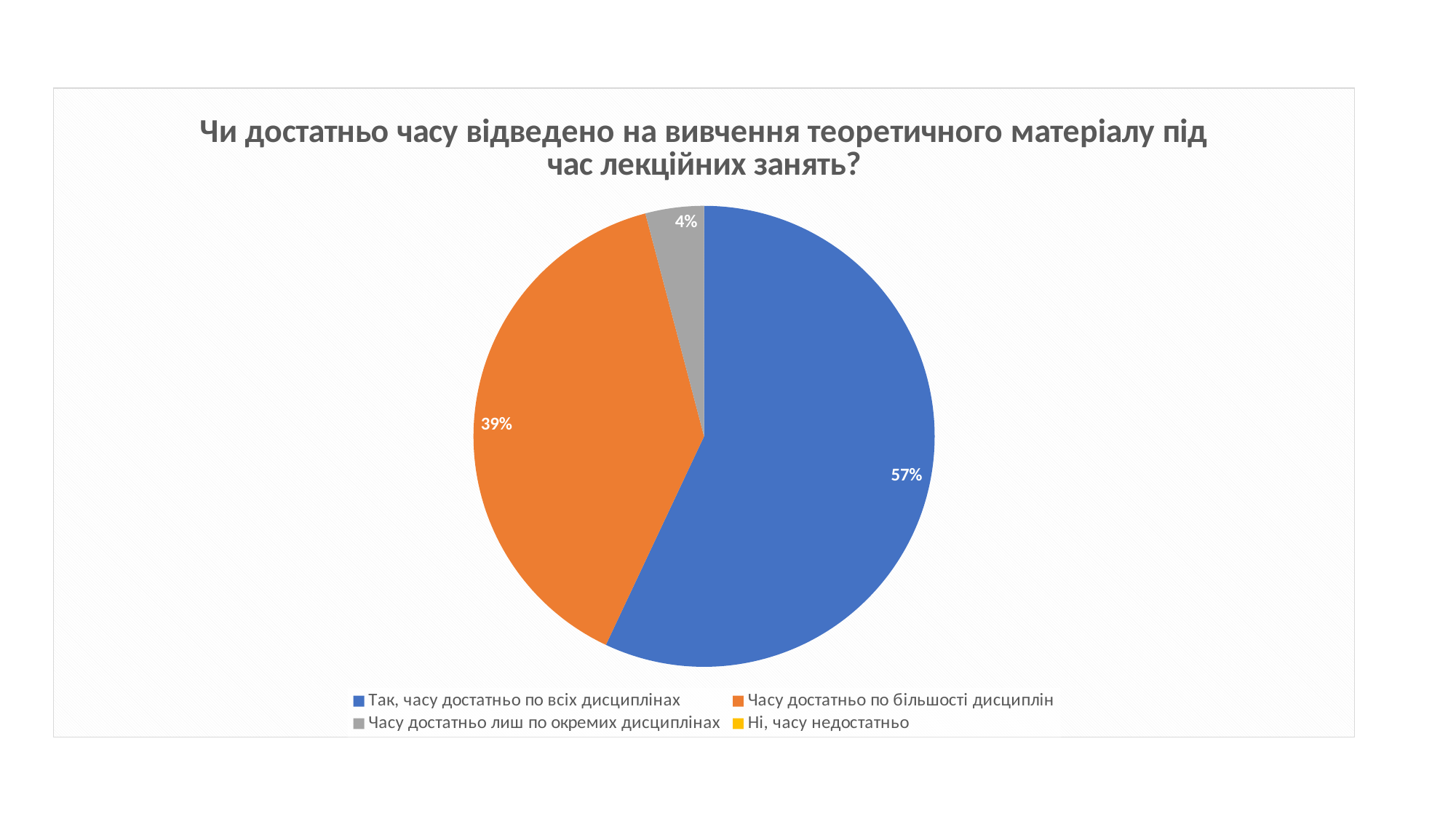
What percentage of respondents answered "Часу достатньо по більшості дисциплін"? 39% What is the title of the chart? Чи достатньо часу відведено на вивчення теоретичного матеріалу під час лекційних занять? What share of the pie does the blue slice represent? 57% What percentage of respondents answered "Часу достатньо лиш по окремих дисциплінах"? 4% What colour represents "Часу достатньо по більшості дисциплін" in the chart? Orange Which of the labelled slices has the smallest share of the pie? Часу достатньо лиш по окремих дисциплінах By how many percentage points does "Так, часу достатньо по всіх дисциплінах" exceed "Часу достатньо по більшості дисциплін"? 18 percentage points Which answer option has the largest share of the pie? Так, часу достатньо по всіх дисциплінах Which is larger: the share for "Часу достатньо по більшості дисциплін" or the share for "Часу достатньо лиш по окремих дисциплінах"? Часу достатньо по більшості дисциплін What percentage of respondents answered "Так, часу достатньо по всіх дисциплінах"? 57% How many answer options are listed in the legend? 4 What type of chart is shown on the slide? Pie chart